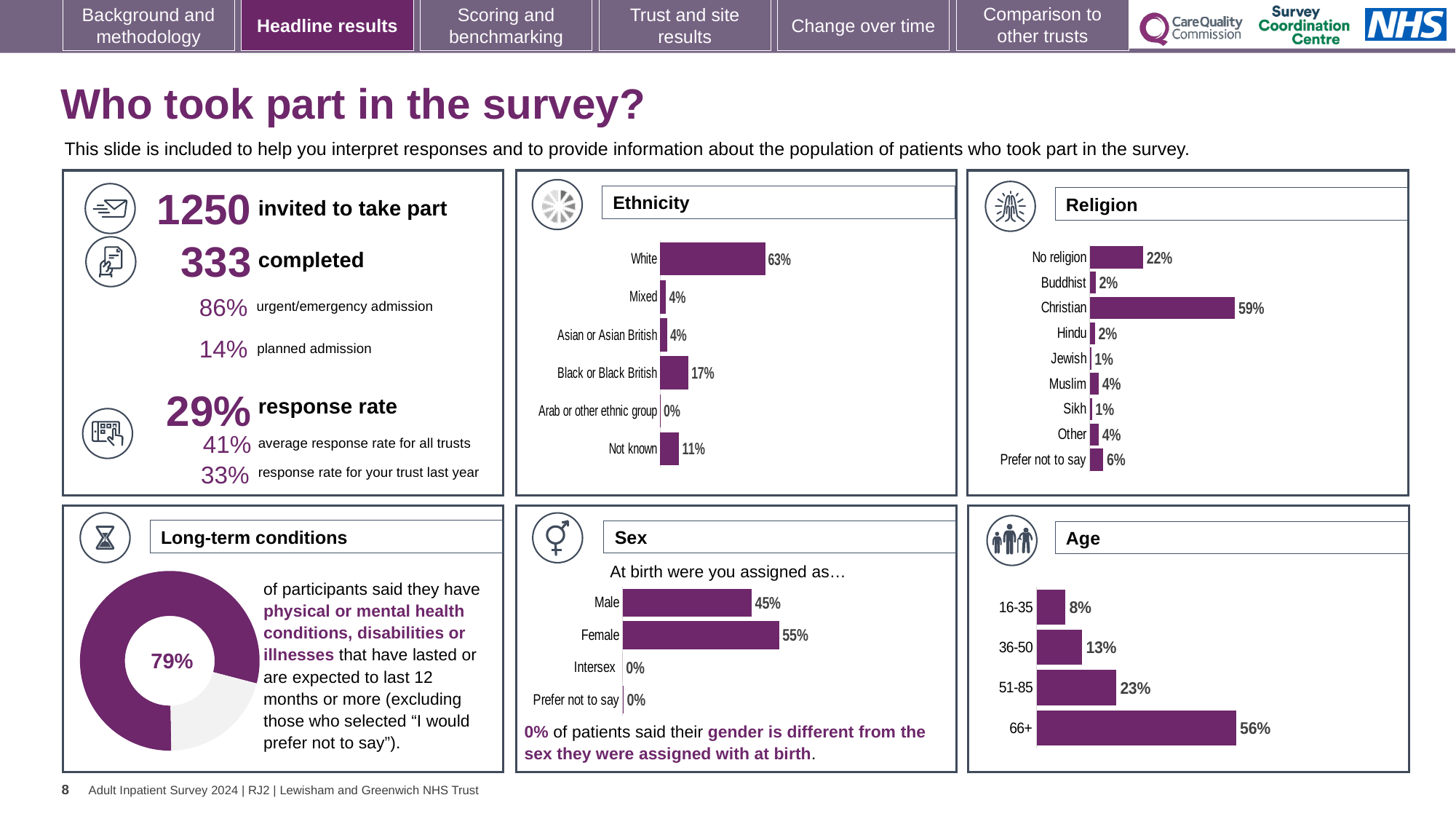
What type of chart is the Long-term conditions chart? Doughnut chart In the Age chart, what is the value for the 66+ group? 56% In the Ethnicity chart, what is the difference between White and Black or Black British? 46% In the Religion chart, which category has the highest value? Christian In the Sex chart, what is the difference between the Female and Male percentages? 10% In the Long-term conditions chart, what share of participants said they have long-term conditions? 79% In the Ethnicity chart, which is larger: Black or Black British or Not known? Black or Black British How many categories are shown in the Religion chart? 9 In the Ethnicity chart, what percentage of respondents were White? 63% In the Age chart, do the values rise or fall as age increases from 16-35 to 66+? Rise In the Age chart, which age group has the lowest value? 16-35 In the Religion chart, what is the value for No religion? 22%